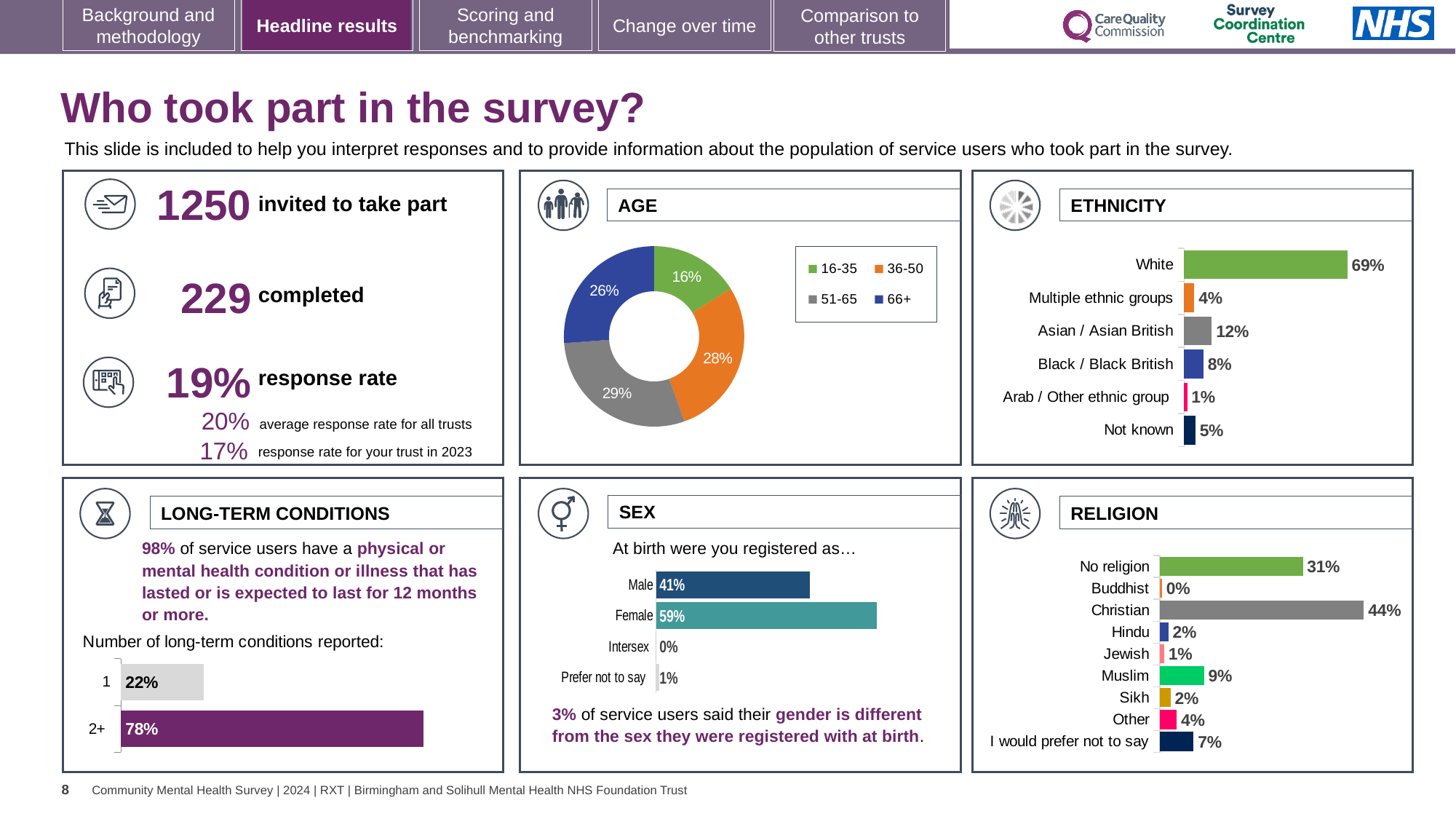
In the AGE chart, what share of respondents were aged 36-50? 28% In the ETHNICITY chart, what is the difference between White and Black / Black British? 61% In the SEX chart, what is the value for Female? 59% In the ETHNICITY chart, what is the value for Asian / Asian British? 12% In the RELIGION chart, which category has the highest value? Christian In the LONG-TERM CONDITIONS chart, what is the value for 2+ conditions? 78% In the ETHNICITY chart, how many categories are shown? 6 In the SEX chart, which is larger, Male or Female? Female In the AGE chart, which age group has the largest share? 51-65 What kind of chart is the AGE chart? Doughnut chart In the AGE chart, how many age groups does the legend list? 4 In the ETHNICITY chart, which category has the lowest value? Arab / Other ethnic group